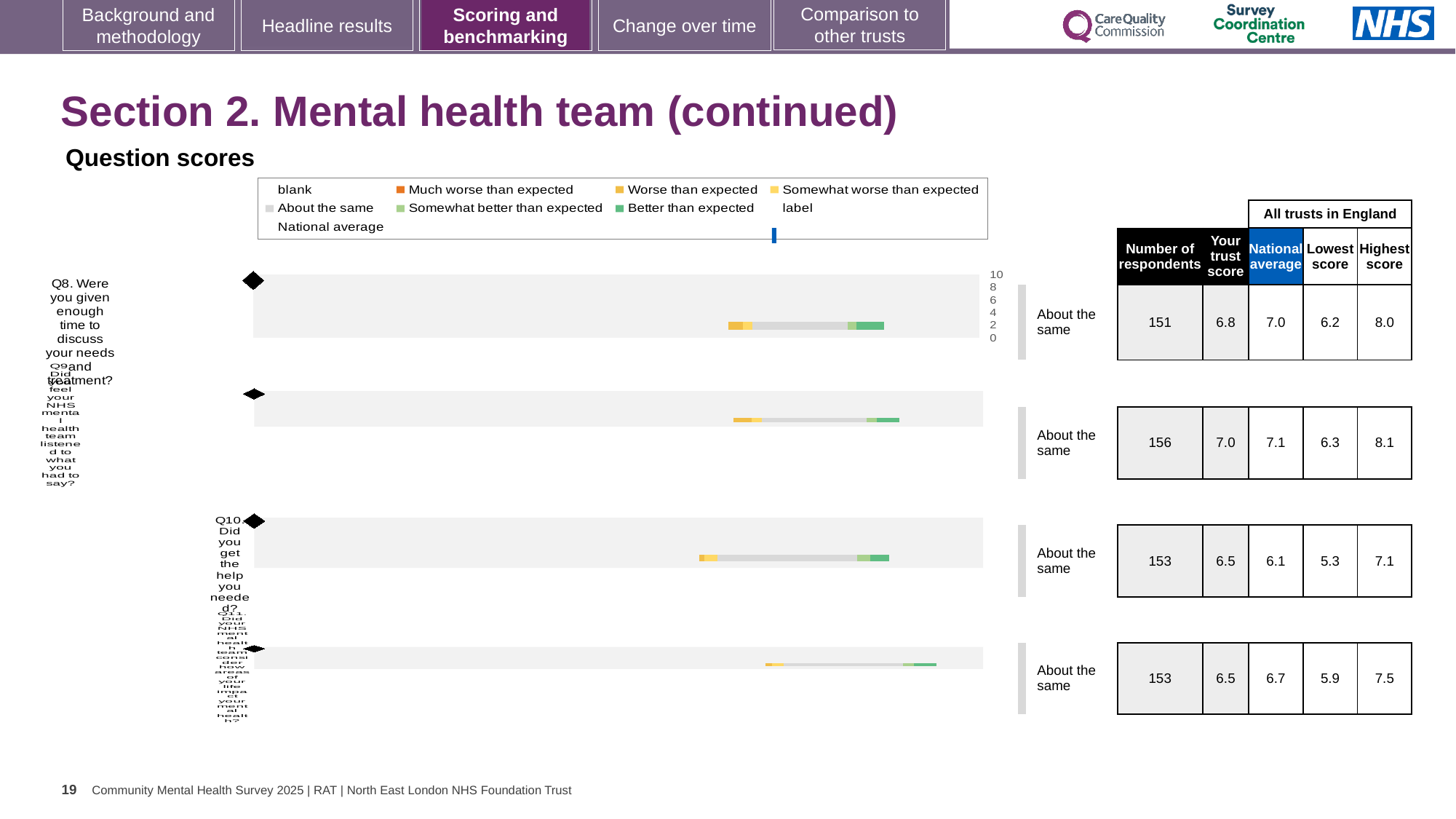
What is the highest tick value shown on the score axis of the chart? 10 Which question has the lowest national average score? Q10 How many respondents answered Q9? 156 Which question has the highest trust score? Q9 For Q8, what is the difference between the highest score and the lowest score across all trusts in England? 1.8 What is the national average score for Q10 (Did you get the help you needed?)? 6.1 What is the trust score for Q8 (Were you given enough time to discuss your needs and treatment?)? 6.8 Which legend entry is shown in orange? Much worse than expected What benchmark category is shown next to the bar for Q8? About the same What kind of chart is used to show the question scores on this slide? bar chart How many survey questions (Q8 to Q11) are plotted as bars on this slide? 4 For Q10, is the trust score higher or lower than the national average? higher